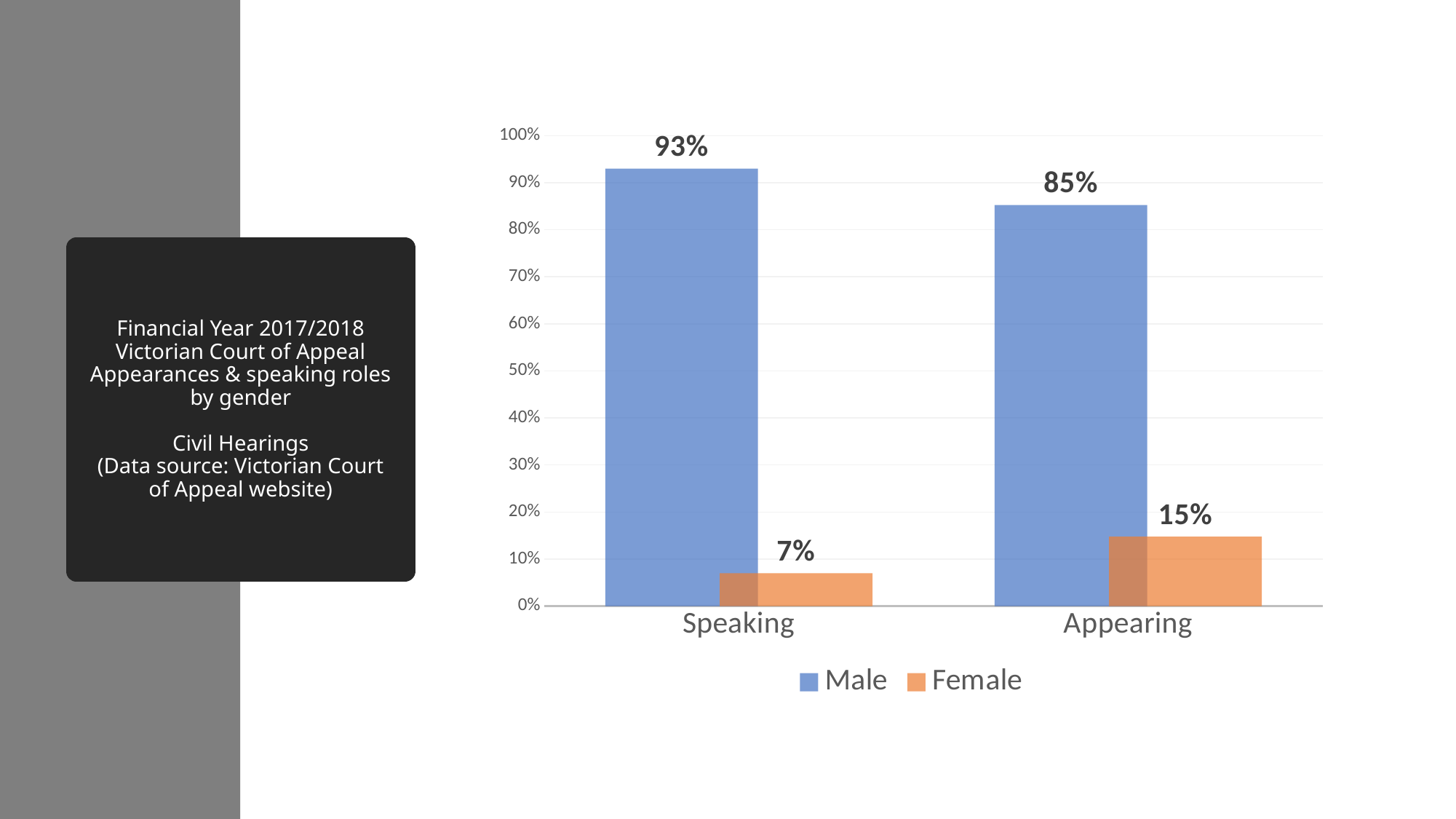
What is the difference between the Male and Female values for Appearing? 70% What is the Female value for Speaking? 7% How many series does the legend list? 2 What is the Male value for Appearing? 85% What is the difference between the Female values for Appearing and Speaking? 8% How many categories are shown on the x axis? 2 Which category has the lowest Female value? Speaking What is the Female value for Appearing? 15% What is the Male value for Speaking? 93% Which category has the highest Male value? Speaking What kind of chart is shown on the slide? Bar chart Which is larger, the Male value for Speaking or the Male value for Appearing? Speaking